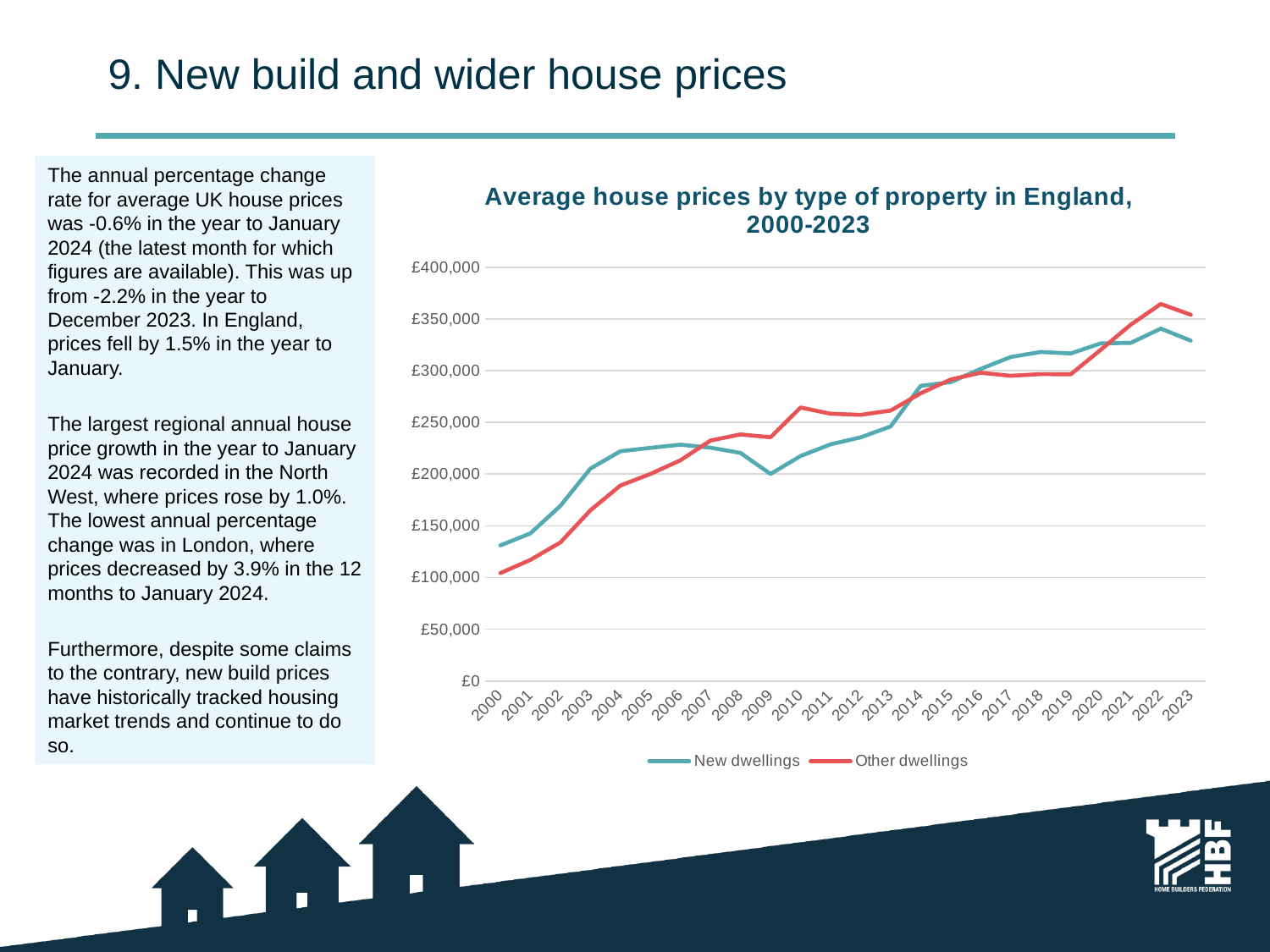
In which year is the New dwellings series at its lowest value? 2000 How many years are plotted along the x axis? 24 Is the value for New dwellings in 2000 greater or less than £100,000? greater In 2009, which series has the higher value, New dwellings or Other dwellings? Other dwellings Which series is drawn in red? Other dwellings In which year does the Other dwellings series reach its highest value? 2022 Is the value for New dwellings in 2023 greater or less than £350,000? less How many series does the legend list? 2 What kind of chart is shown on the slide? Line chart In 2003, which series has the higher value, New dwellings or Other dwellings? New dwellings What is the title of the chart? Average house prices by type of property in England, 2000-2023 Overall, do the values for New dwellings rise or fall from 2000 to 2023? Rise